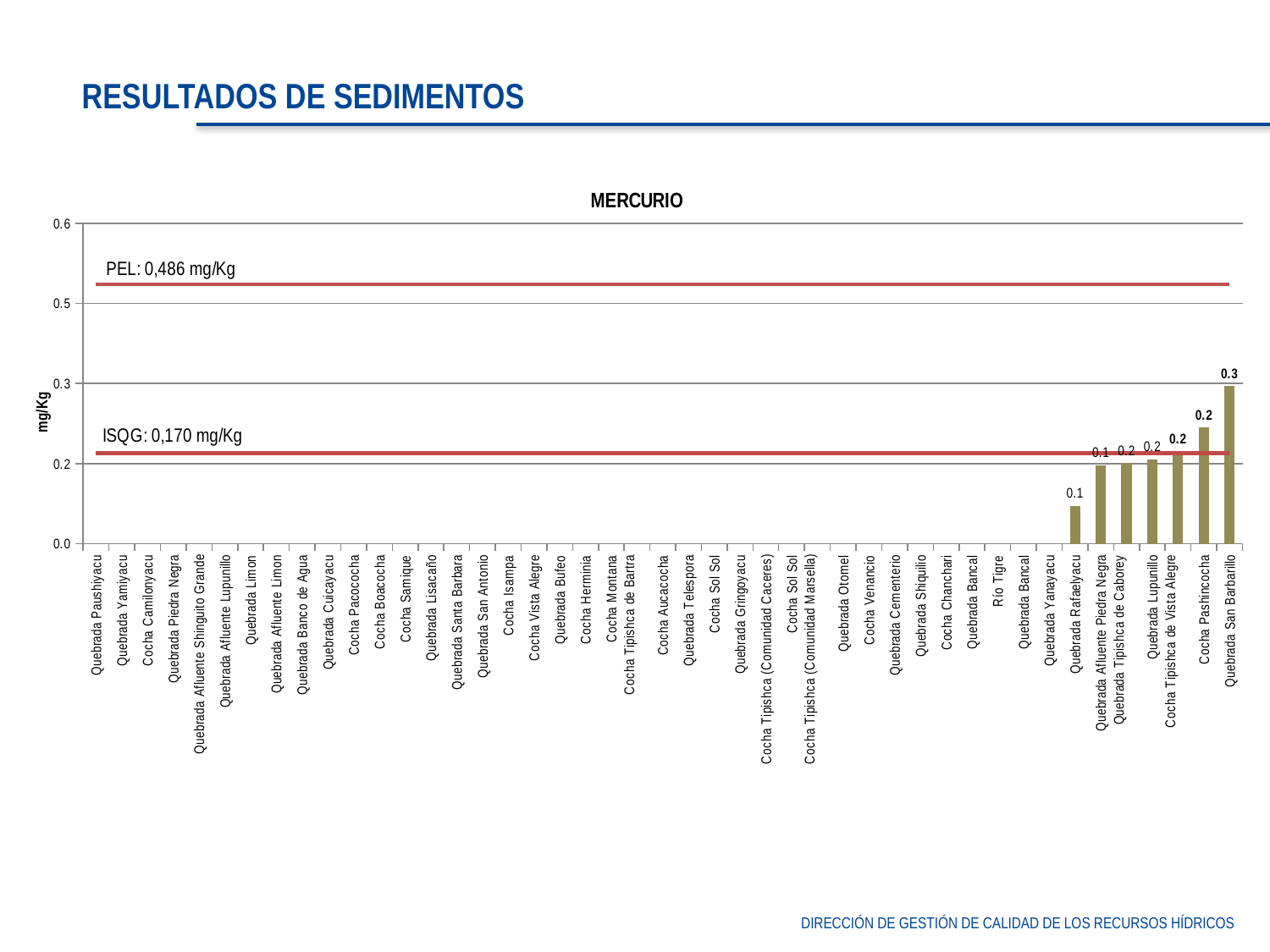
What is the mercury value shown for Quebrada San Barbarillo? 0.3 What is the mercury value shown for Quebrada Rafaelyacu? 0.1 Which site has the highest mercury value on the chart? Quebrada San Barbarillo What is the mercury value shown for Cocha Pashincocha? 0.2 Is the value for Quebrada San Barbarillo greater or less than 0.2? greater What is the title of the chart? MERCURIO Is the value for Quebrada Rafaelyacu greater or less than 0.2? less What value is given for the PEL reference line on the chart? 0,486 mg/Kg How many sites have a visible bar with a data label on the chart? 7 What is the difference between the values for Quebrada San Barbarillo and Quebrada Rafaelyacu? 0.2 Which is larger, the value for Quebrada San Barbarillo or the value for Quebrada Rafaelyacu? Quebrada San Barbarillo What type of chart is shown on the slide? bar chart